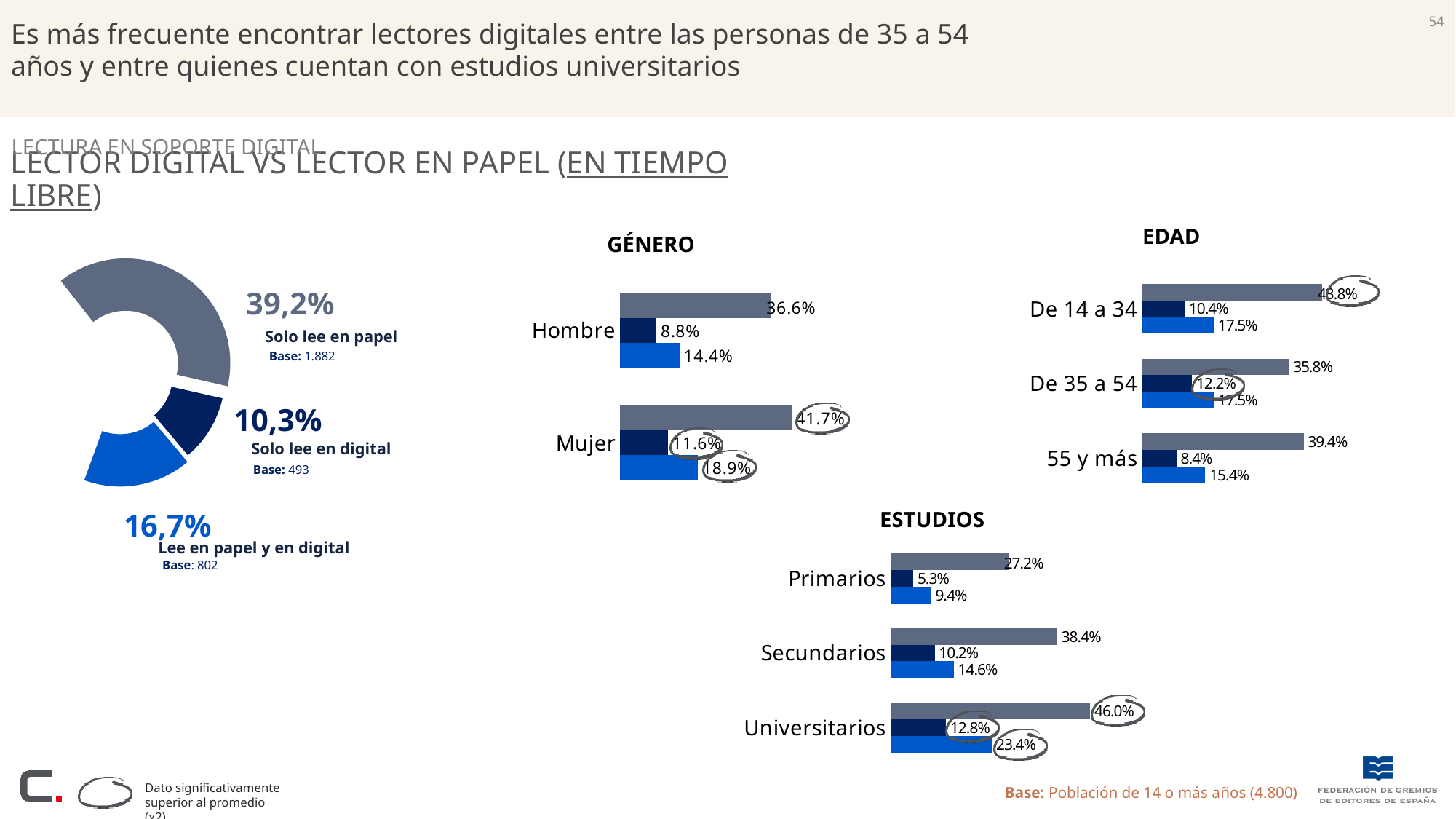
In the GÉNERO chart, which has the larger dark blue bar value, Hombre or Mujer? Mujer What is the title of the bar chart at the bottom centre of the slide? ESTUDIOS In the GÉNERO chart, what is the value of the light blue bar for Mujer? 18.9% In the donut chart on the left, what percentage corresponds to 'Solo lee en digital'? 10,3% In the GÉNERO chart, what is the value of the grey bar for Hombre? 36.6% In the ESTUDIOS chart, what is the value of the light blue bar for Universitarios? 23.4% In the ESTUDIOS chart, what is the difference between the grey bar values for Universitarios and Primarios? 18.8% What kind of chart is the chart on the left of the slide showing 39,2%, 10,3% and 16,7%? Donut chart In the EDAD chart, which category has the highest grey bar value? De 14 a 34 In the ESTUDIOS chart, which category has the lowest grey bar value? Primarios In the EDAD chart, what is the value of the dark blue bar for De 35 a 54? 12.2% How many categories are shown in the EDAD chart? 3